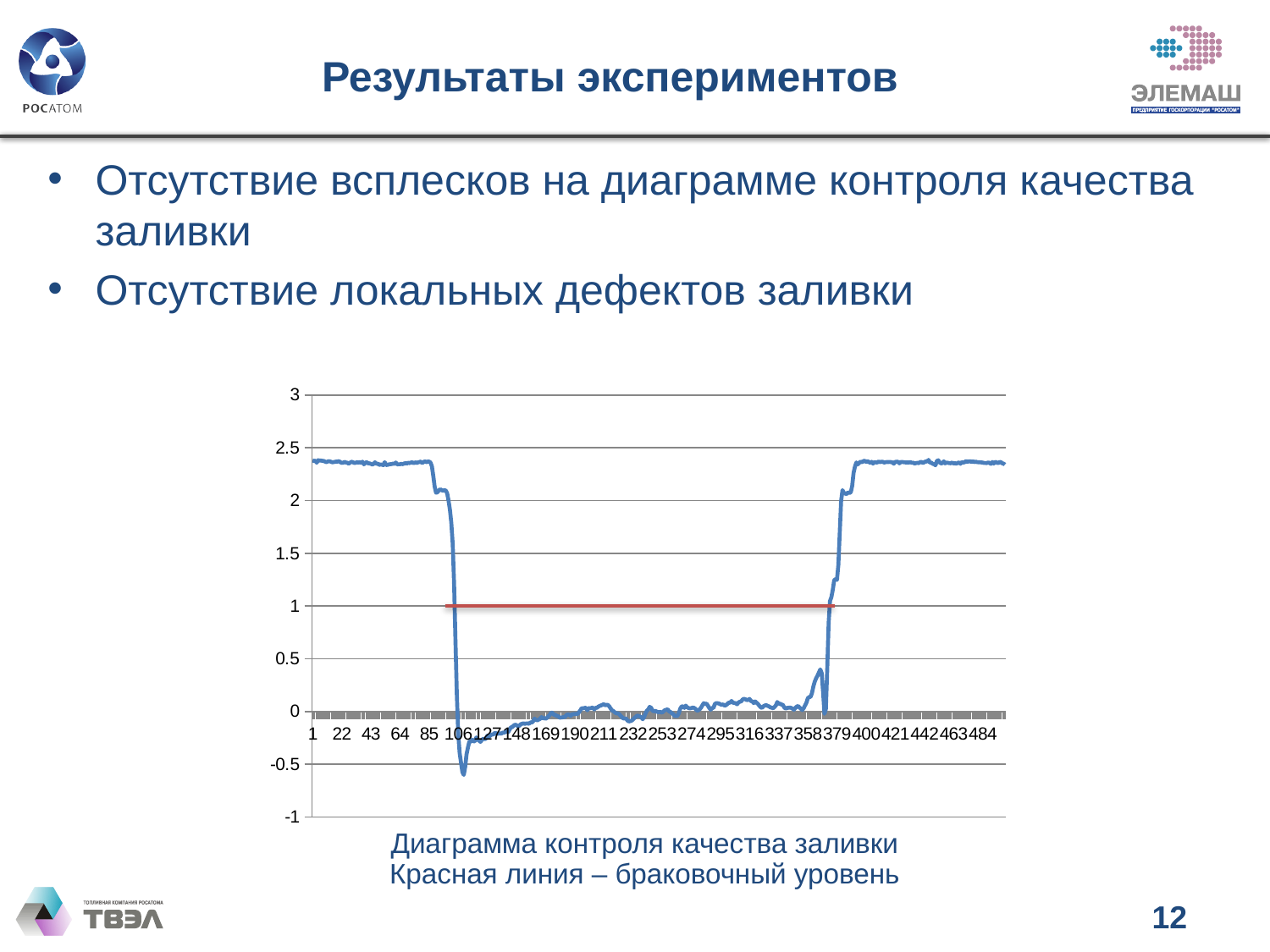
Does the blue line rise or fall between x = 358 and x = 400? rise Is the value of the blue line at x = 1 greater or less than 2? greater Is the value of the blue line at x = 295 greater or less than 1? less Does the blue line rise or fall between x = 85 and x = 127? fall Which is larger: the value of the blue line at x = 22 or at x = 190? x = 22 At what level on the y axis is the red horizontal line drawn? 1 What is the highest value shown on the y axis? 3 What kind of chart is shown on the slide? line chart Is the value of the blue line at x = 232 greater or less than 0.5? less According to the caption, what does the red line represent? браковочный уровень